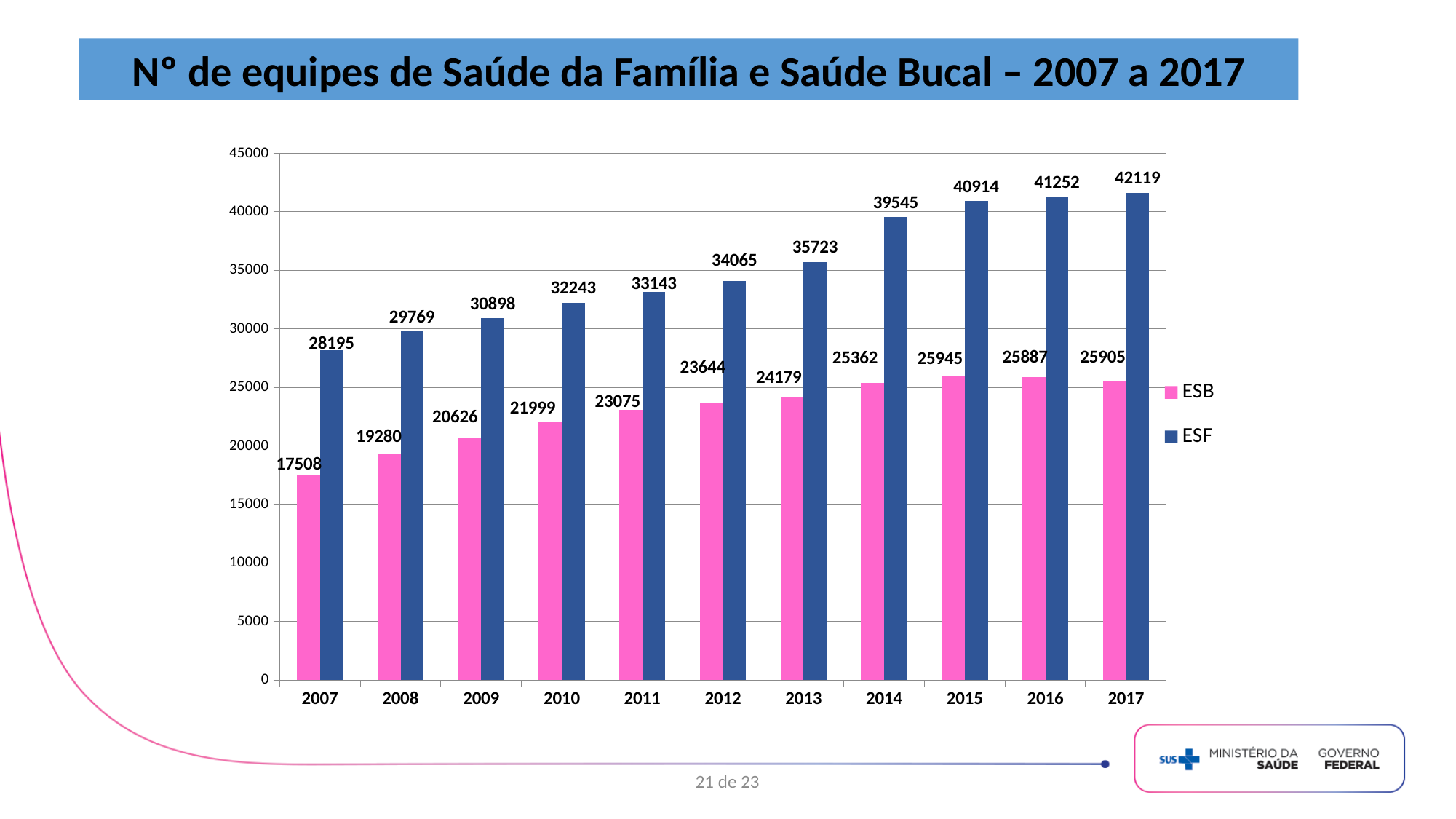
What is the difference between the ESF and ESB values in 2017? 16214 What is the value for ESF in 2014? 39545 By how much did the ESF value increase from 2007 to 2017? 13924 How many years are shown on the x axis? 11 How many series does the legend list? 2 Does the ESF series rise or fall from 2007 to 2017? rise What is the value for ESB in 2010? 21999 In which year is the ESF value highest? 2017 What kind of chart is shown on the slide? bar chart In which year is the ESB value lowest? 2007 Is the ESB value for 2009 greater or less than 25000? less Which is larger in 2012, the ESB value or the ESF value? ESF